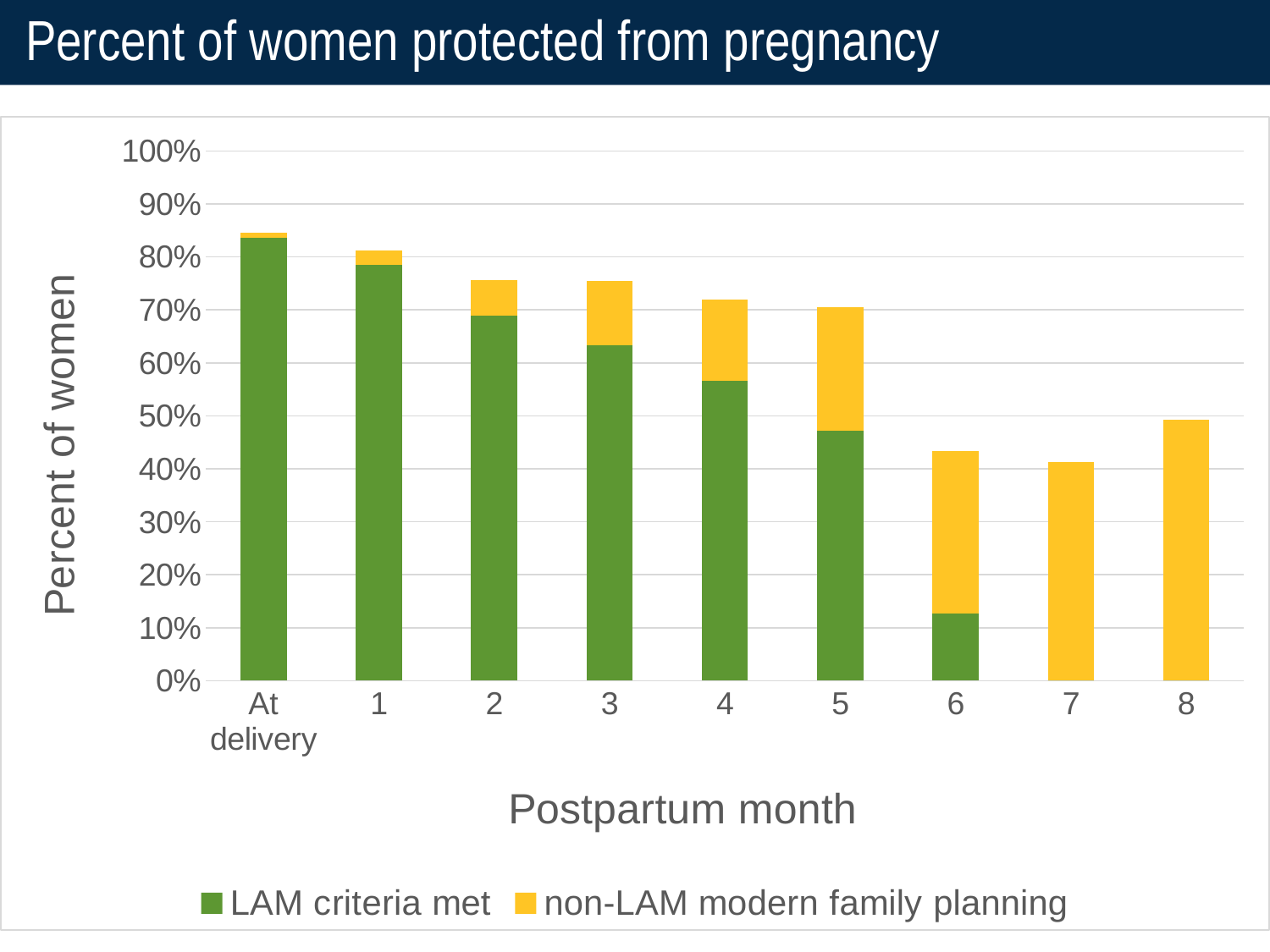
Is the 'LAM criteria met' value at delivery greater or less than 80%? greater Is the 'LAM criteria met' value at postpartum month 5 greater or less than 50%? less How many categories are shown along the x axis? 9 Which postpartum month has the smallest non-zero 'LAM criteria met' segment? 6 Is the total percent of women protected larger at postpartum month 1 or month 5? Month 1 What colour represents 'non-LAM modern family planning' in the chart? Yellow Which postpartum time point has the highest total percent of women protected? At delivery What kind of chart is shown on the slide? Stacked bar chart Is the total percent of women protected at postpartum month 6 greater or less than 40%? greater Does the 'LAM criteria met' series rise or fall from delivery through postpartum month 6? Fall How many series does the legend list? 2 Is the 'LAM criteria met' value larger at postpartum month 2 or month 4? Month 2